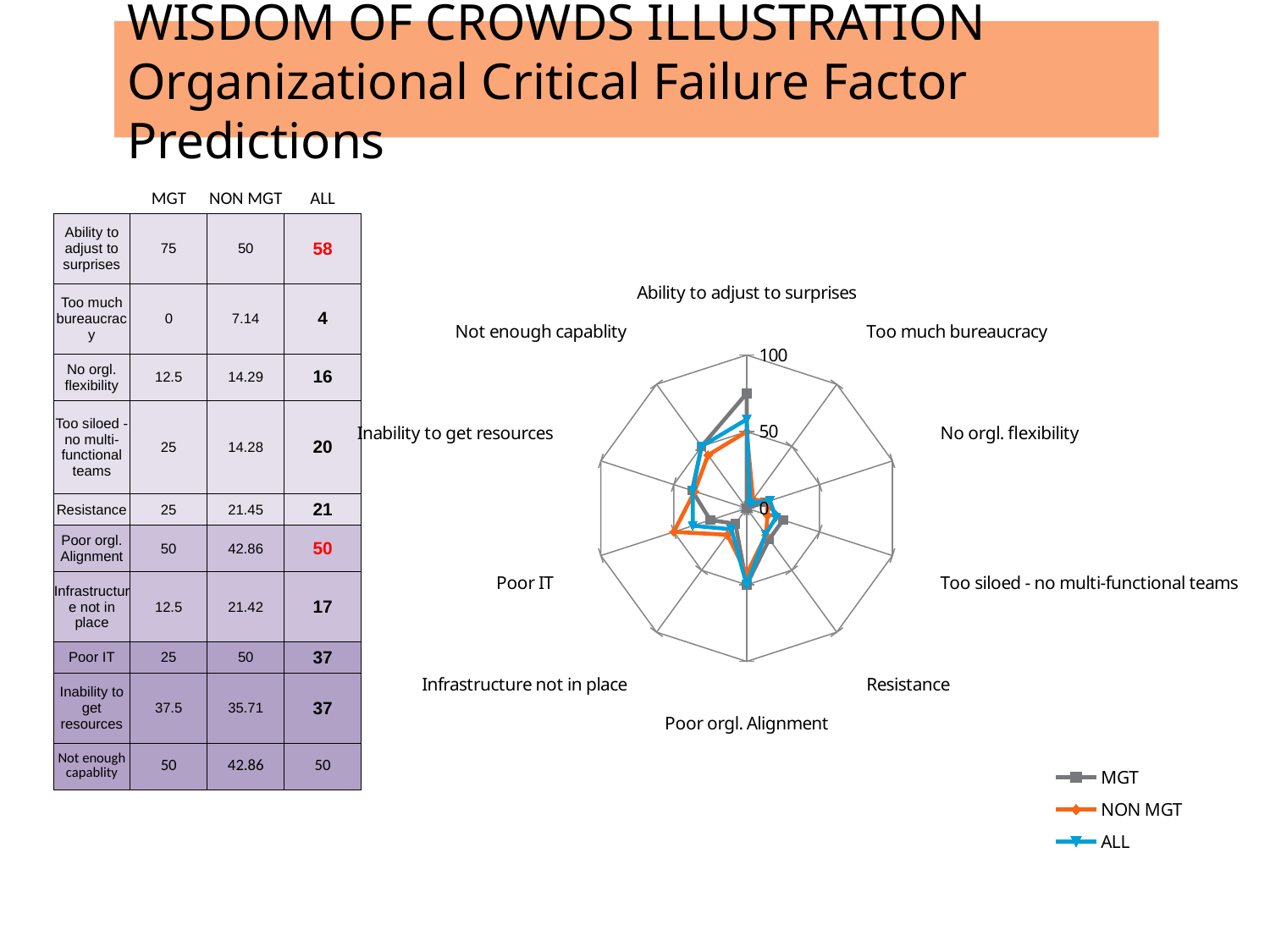
How many categories (axes) does the radar chart have? 10 Is the ALL value for Inability to get resources greater or less than 50? less For Poor IT, which is larger: the MGT value or the NON MGT value? NON MGT Which category has the lowest MGT value? Too much bureaucracy For Ability to adjust to surprises, which is larger: the MGT value or the NON MGT value? MGT Which category has the highest MGT value? Ability to adjust to surprises According to the table on the slide, what is the ALL value for Poor orgl. Alignment? 50 Which category has the lowest NON MGT value? Too much bureaucracy Is the MGT value for Ability to adjust to surprises greater or less than 50? greater Which colour is used for the NON MGT series in the chart? orange What kind of chart is shown on the slide? radar chart How many series does the chart legend list? 3